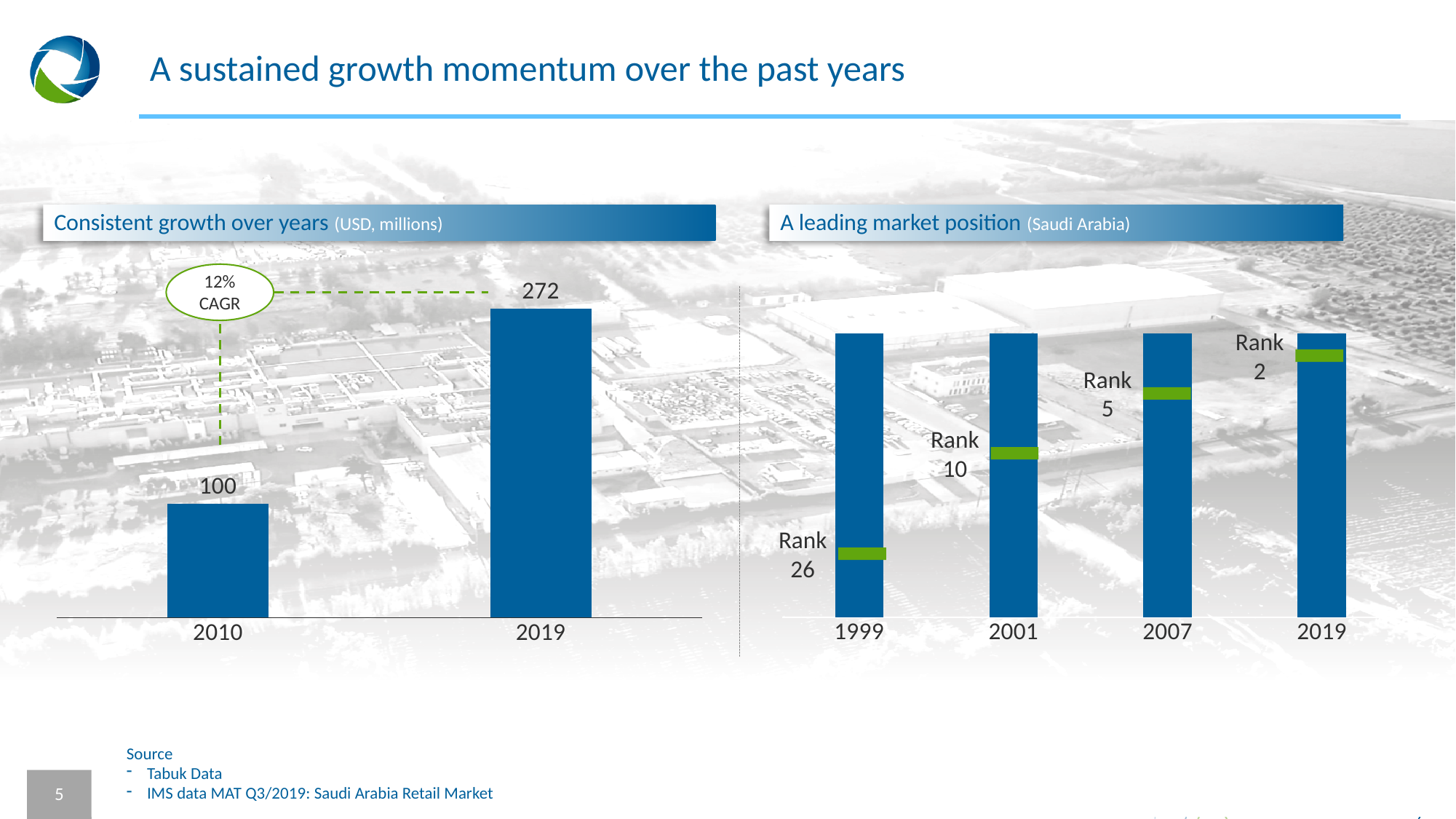
In the 'Consistent growth over years' chart, what CAGR is shown in the callout? 12% In the 'A leading market position' chart, what rank is shown for 1999? Rank 26 In the 'A leading market position' chart, what rank is shown for 2019? Rank 2 In the 'Consistent growth over years' chart, what is the difference between the 2019 and 2010 values? 172 In the 'A leading market position' chart, how many years are shown on the x axis? 4 In the 'Consistent growth over years' chart, what is the value for 2019? 272 What kind of chart is the 'Consistent growth over years' chart? Bar chart In the 'Consistent growth over years' chart, how many years are shown on the x axis? 2 In the 'Consistent growth over years' chart, which year has the higher value, 2010 or 2019? 2019 In the 'A leading market position' chart, does the rank number rise or fall from 1999 to 2019? Fall In the 'A leading market position' chart, what rank is shown for 2007? Rank 5 In the 'Consistent growth over years' chart, what is the value for 2010? 100